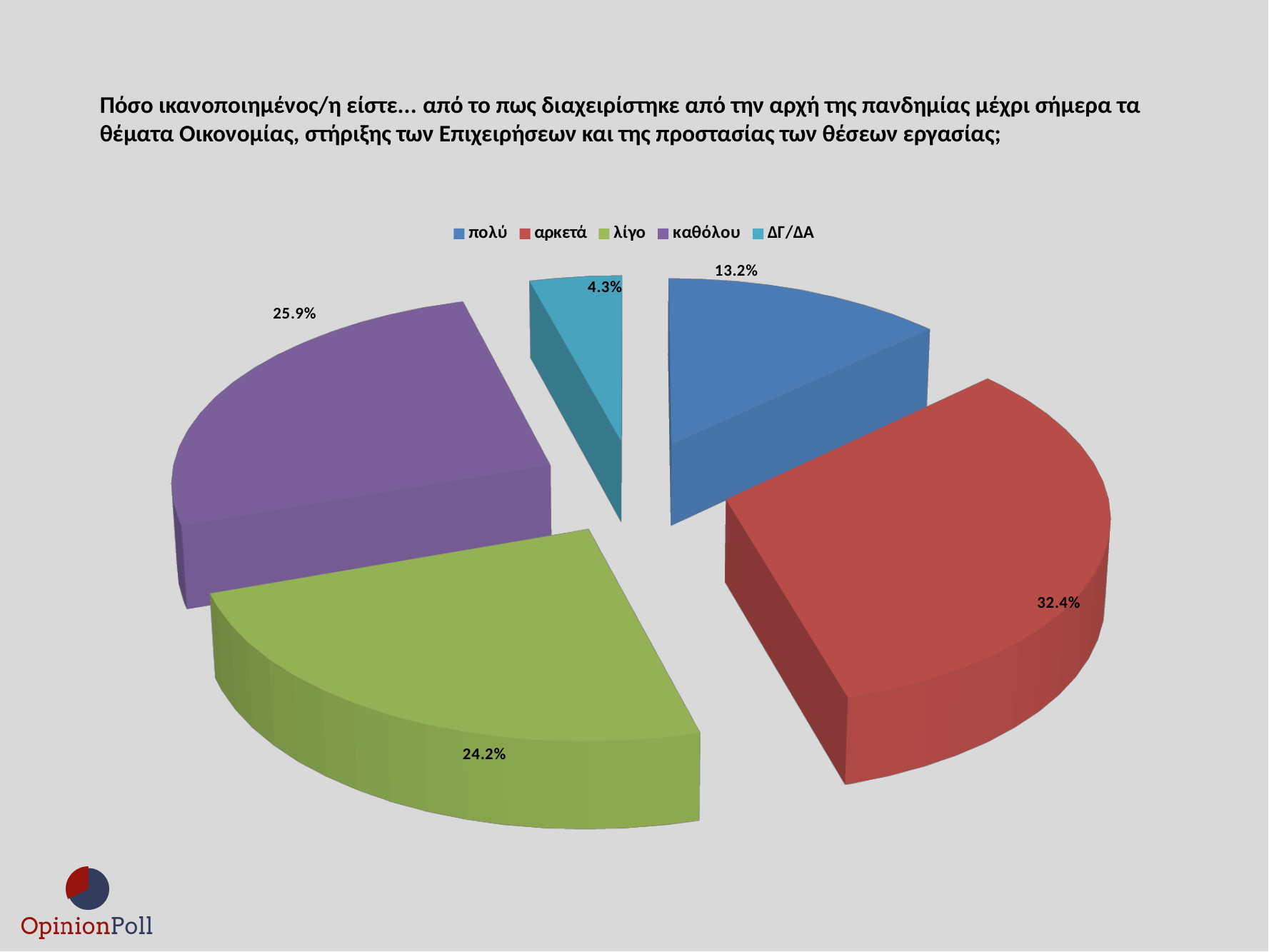
What is the difference between the 'αρκετά' and 'πολύ' percentages? 19.2% What kind of chart is shown on the slide? pie chart What percentage is shown for the 'πολύ' slice? 13.2% Which category has the largest share of the pie? αρκετά What percentage is shown for the 'καθόλου' slice? 25.9% What colour is the 'λίγο' slice? green Which category has the smallest share of the pie? ΔΓ/ΔΑ How many slices does the pie chart have? 5 How many entries does the legend list? 5 What percentage is shown for the 'αρκετά' slice? 32.4% Which is larger, the 'καθόλου' slice or the 'λίγο' slice? καθόλου What percentage is shown for the 'ΔΓ/ΔΑ' slice? 4.3%